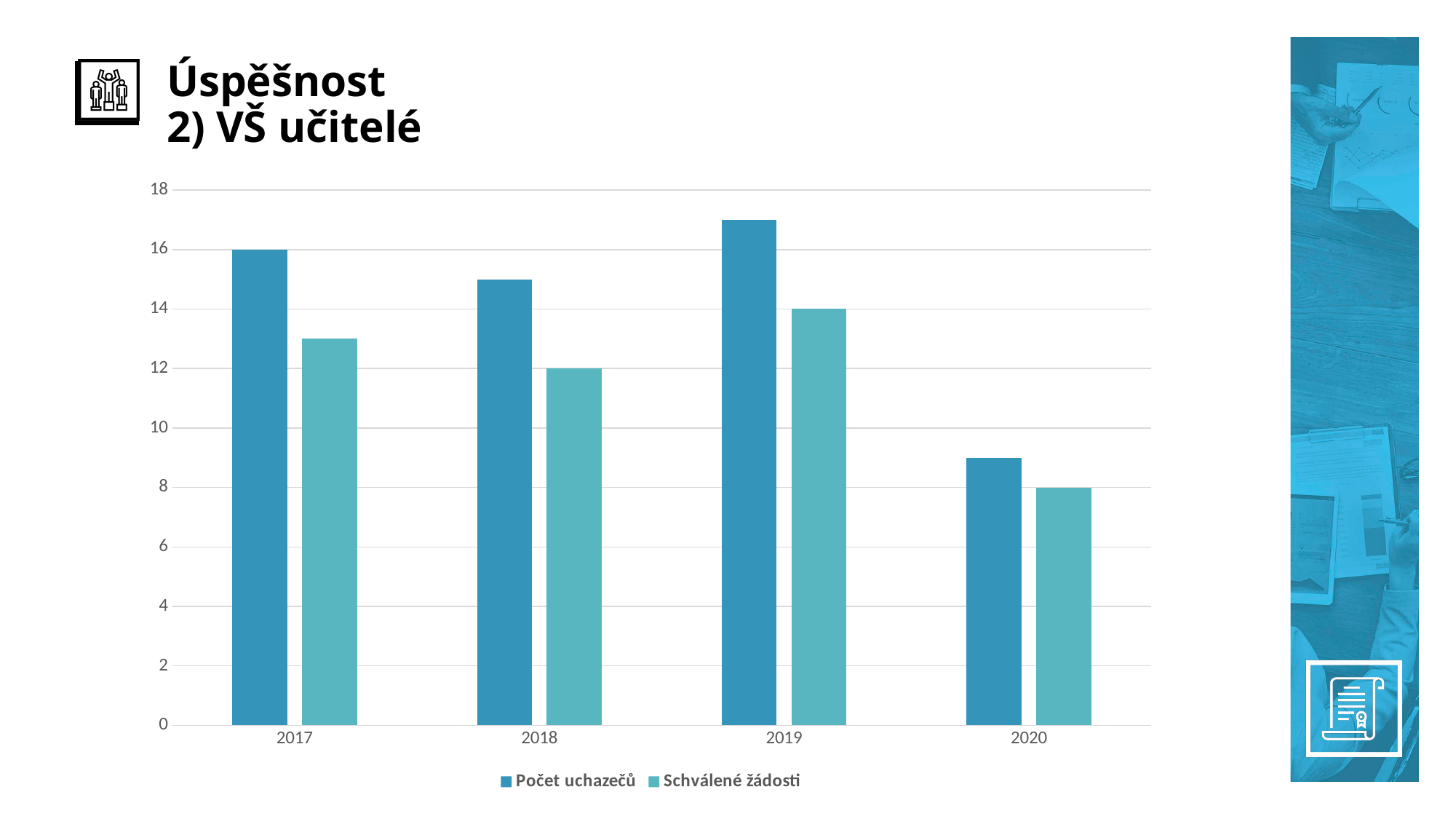
How many years are shown on the x axis? 4 What is the difference between Schválené žádosti in 2019 and in 2018? 2 How many series does the legend list? 2 What is the value of Schválené žádosti for 2019? 14 Is the value of Počet uchazečů for 2020 greater or less than 10? less In which year is Počet uchazečů highest? 2019 What is the value of Schválené žádosti for 2020? 8 What is the value of Schválené žádosti for 2018? 12 What type of chart is shown on the slide? bar chart What is the value of Počet uchazečů for 2017? 16 Which series is shown in the darker blue colour? Počet uchazečů In which year is Schválené žádosti lowest? 2020